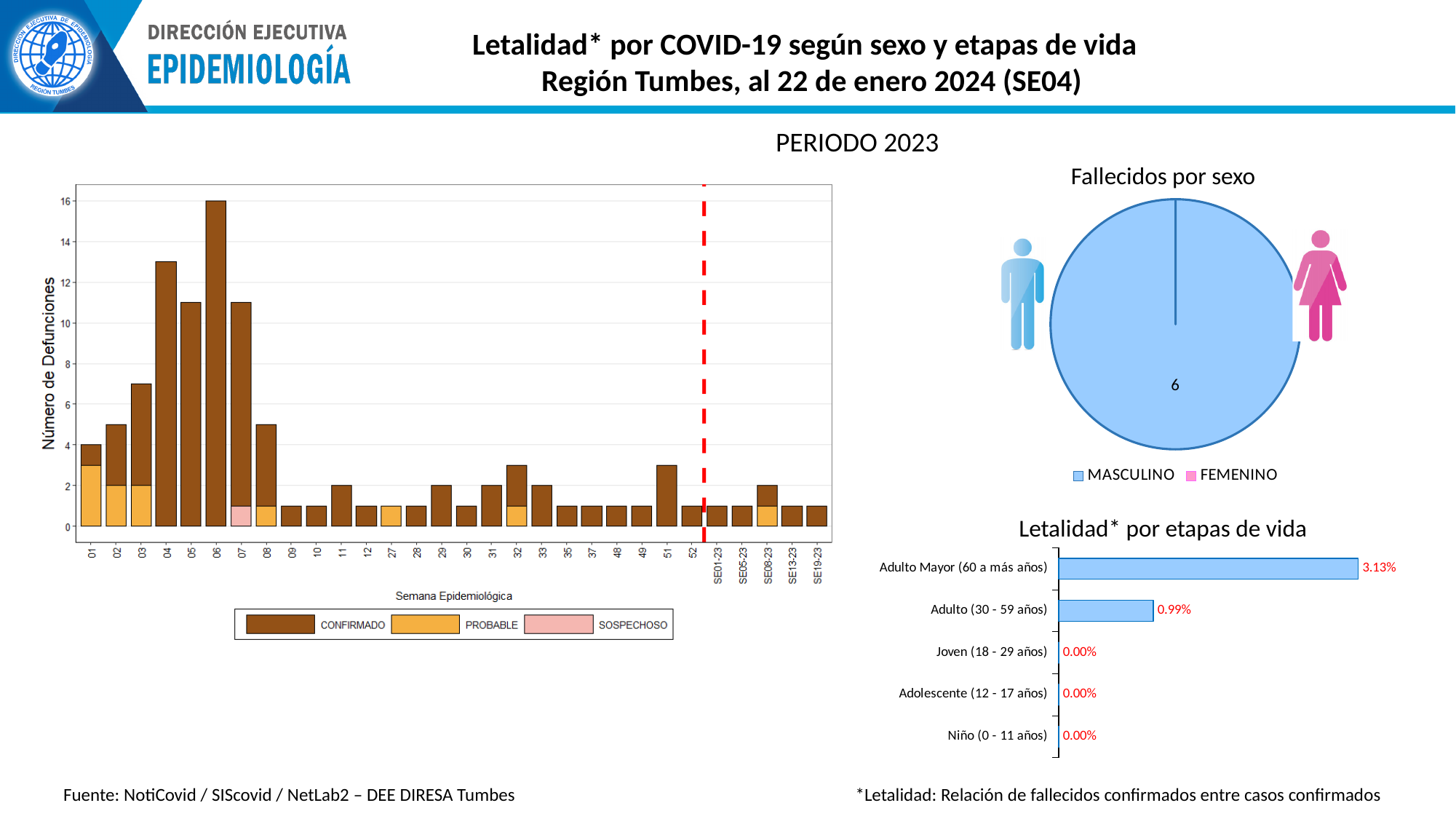
In the bar chart of deaths by epidemiological week (left), how many series does the legend list? 3 In the bar chart of deaths by epidemiological week (left), is the value for week 04 greater or less than 12? greater In the bar chart of deaths by epidemiological week (left), which week has the highest number of deaths? 06 In the 'Letalidad* por etapas de vida' chart, what is the difference between Adulto Mayor (60 a más años) and Adulto (30 - 59 años)? 2.14% In the 'Letalidad* por etapas de vida' chart, what is the value for Adulto Mayor (60 a más años)? 3.13% In the 'Fallecidos por sexo' pie chart, what value is shown for MASCULINO? 6 In the 'Letalidad* por etapas de vida' chart, how many age groups are shown? 5 In the 'Letalidad* por etapas de vida' chart, which age group has the highest value? Adulto Mayor (60 a más años) In the 'Letalidad* por etapas de vida' chart, what is the value for Adulto (30 - 59 años)? 0.99% In the 'Fallecidos por sexo' pie chart, how many series does the legend list? 2 In the 'Letalidad* por etapas de vida' chart, what is the value for Joven (18 - 29 años)? 0.00% In the bar chart of deaths by epidemiological week (left), what is the total number of deaths in week 06? 16